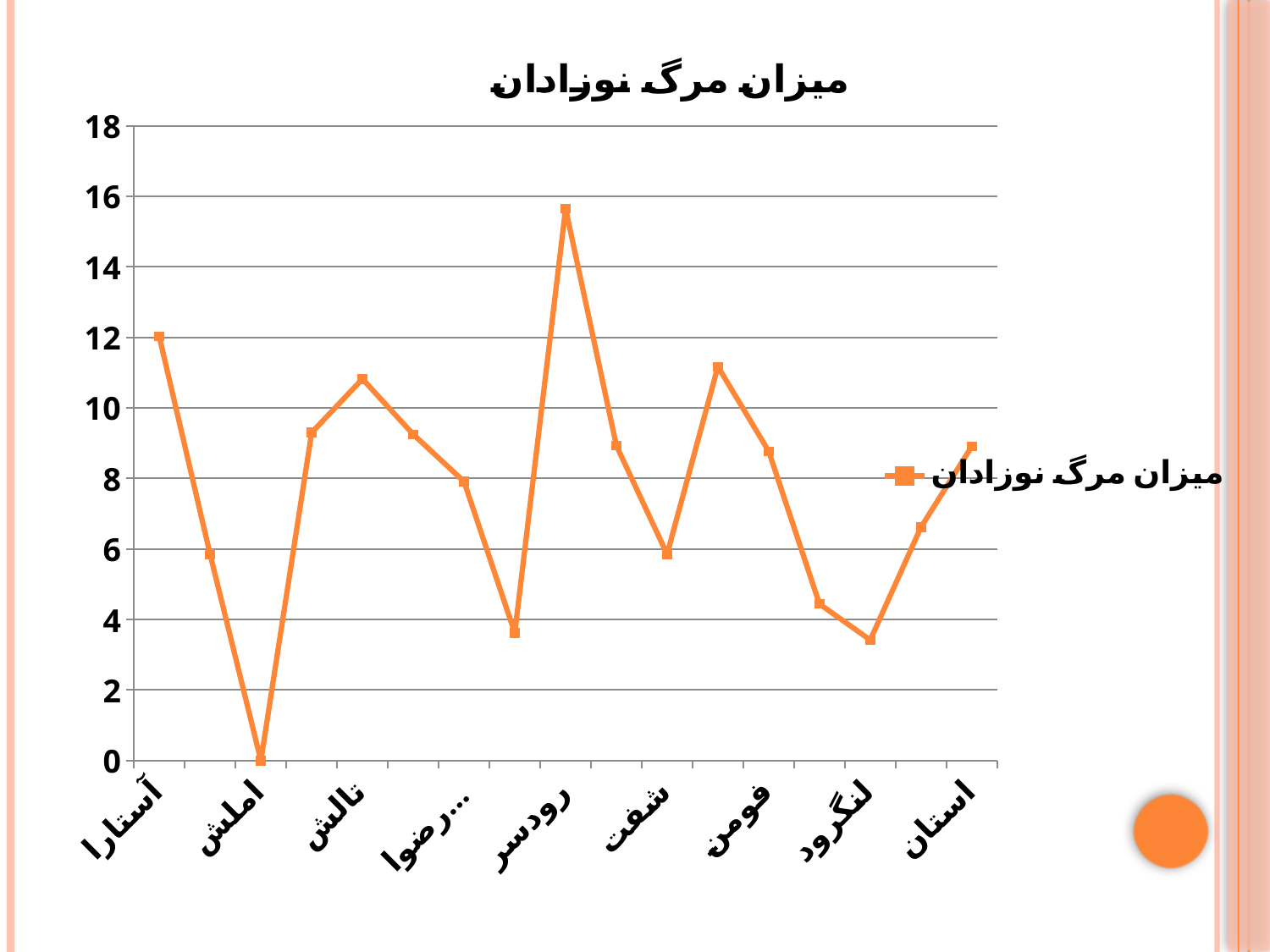
Is the value for لنگرود greater or less than 4? less Which is larger, the value for آستارا or the value for املش? آستارا Which labelled category has the highest value? رودسر What is the title of the chart? میزان مرگ نوزادان Which labelled category has the lowest value? املش How many series does the legend list? 1 Is the value for تالش greater or less than 10? greater Which is larger, the value for فومن or the value for لنگرود? فومن How many category labels are shown on the x axis? 9 Is the value for رودسر greater or less than 14? greater What kind of chart is shown on the slide? line chart What is the value for املش? 0